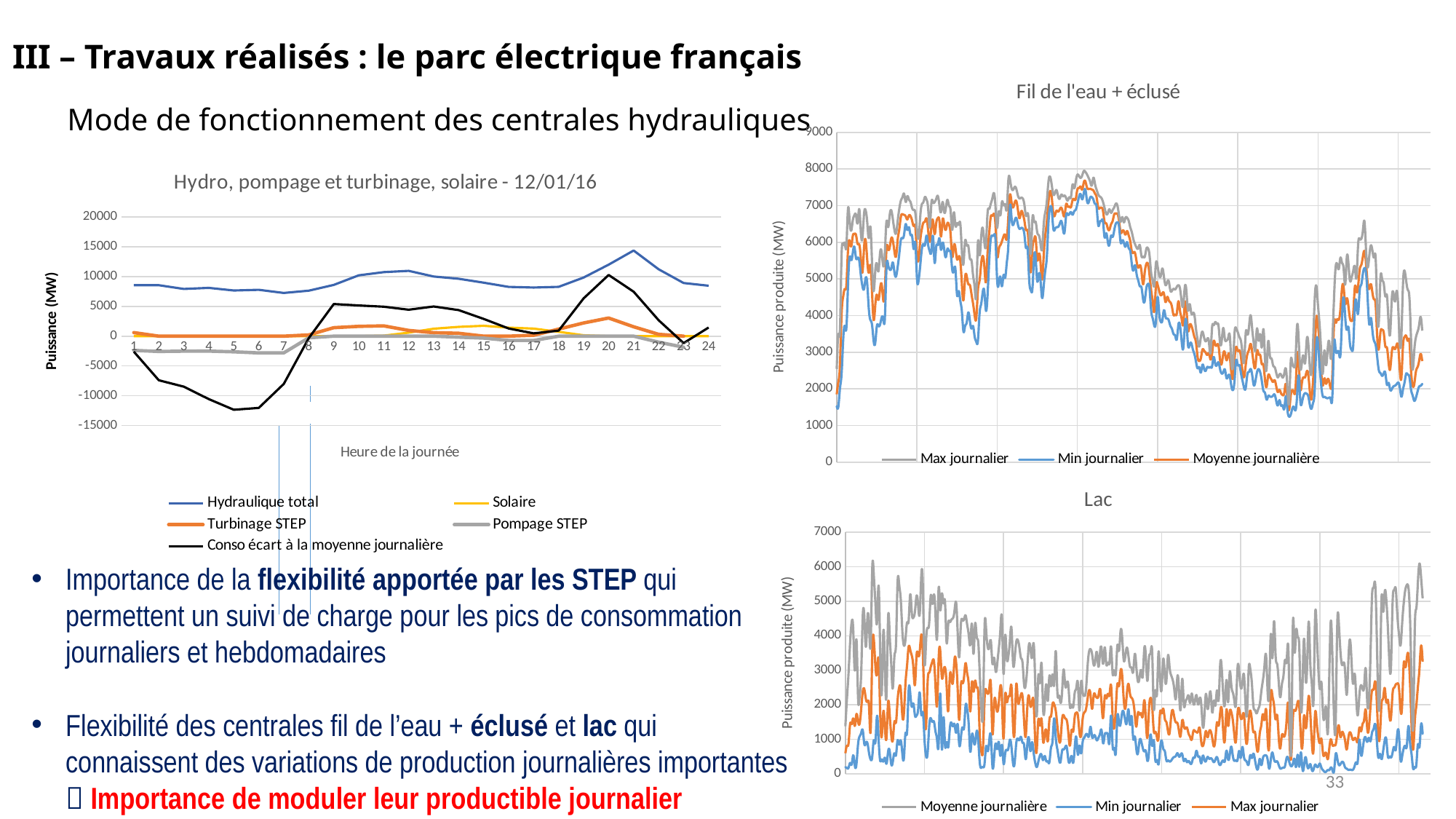
In the "Hydro, pompage et turbinage, solaire - 12/01/16" chart, is the value of Conso écart à la moyenne journalière at hour 6 greater or less than -10000? less How many hours are plotted along the x axis of the "Hydro, pompage et turbinage, solaire - 12/01/16" chart? 24 What kind of chart is "Hydro, pompage et turbinage, solaire - 12/01/16"? line chart In the "Fil de l'eau + éclusé" chart, is the highest value of Max journalier greater or less than 7000? greater In the "Hydro, pompage et turbinage, solaire - 12/01/16" chart, is the value of Hydraulique total at hour 21 greater or less than 10000? greater In the "Hydro, pompage et turbinage, solaire - 12/01/16" chart, at which hour does Hydraulique total reach its highest value? 21 What is the x-axis title of the "Hydro, pompage et turbinage, solaire - 12/01/16" chart? Heure de la journée What kind of chart is the "Lac" chart? line chart In the "Hydro, pompage et turbinage, solaire - 12/01/16" chart, at hour 20, which is larger: Hydraulique total or Conso écart à la moyenne journalière? Hydraulique total How many series does the legend of the "Hydro, pompage et turbinage, solaire - 12/01/16" chart list? 5 How many series does the legend of the "Fil de l'eau + éclusé" chart list? 3